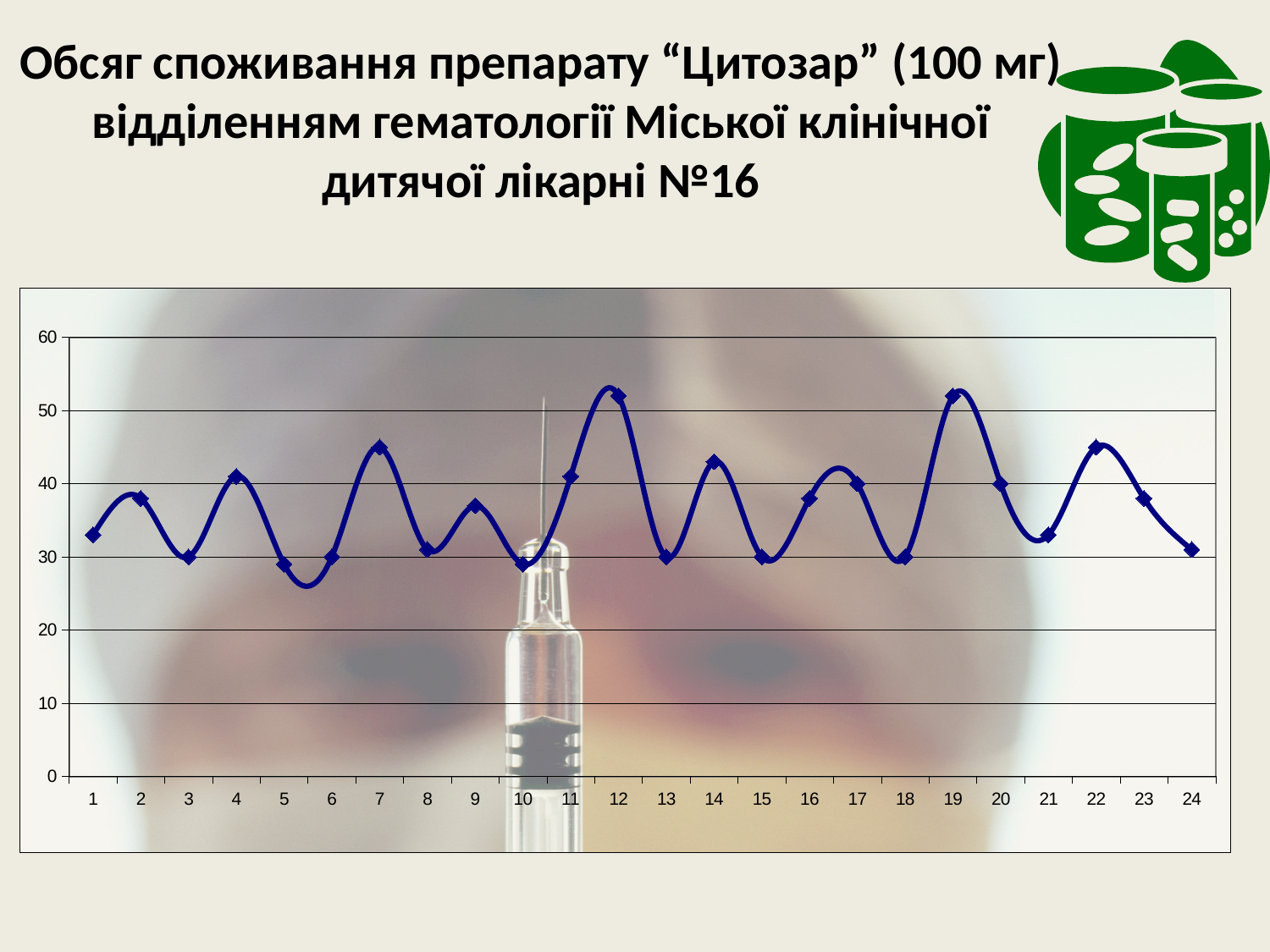
Is the value at point 1 greater or less than 30? greater How many points are plotted along the x axis? 24 Is the value at point 12 greater or less than 50? greater Is the value at point 7 greater or less than 40? greater Which is larger, the value at point 7 or the value at point 8? point 7 What kind of chart is shown on the slide? line chart What is the highest value shown on the y axis? 60 Does the line rise or fall from point 18 to point 19? rise Which is larger, the value at point 12 or the value at point 13? point 12 Does the line rise or fall from point 12 to point 13? fall